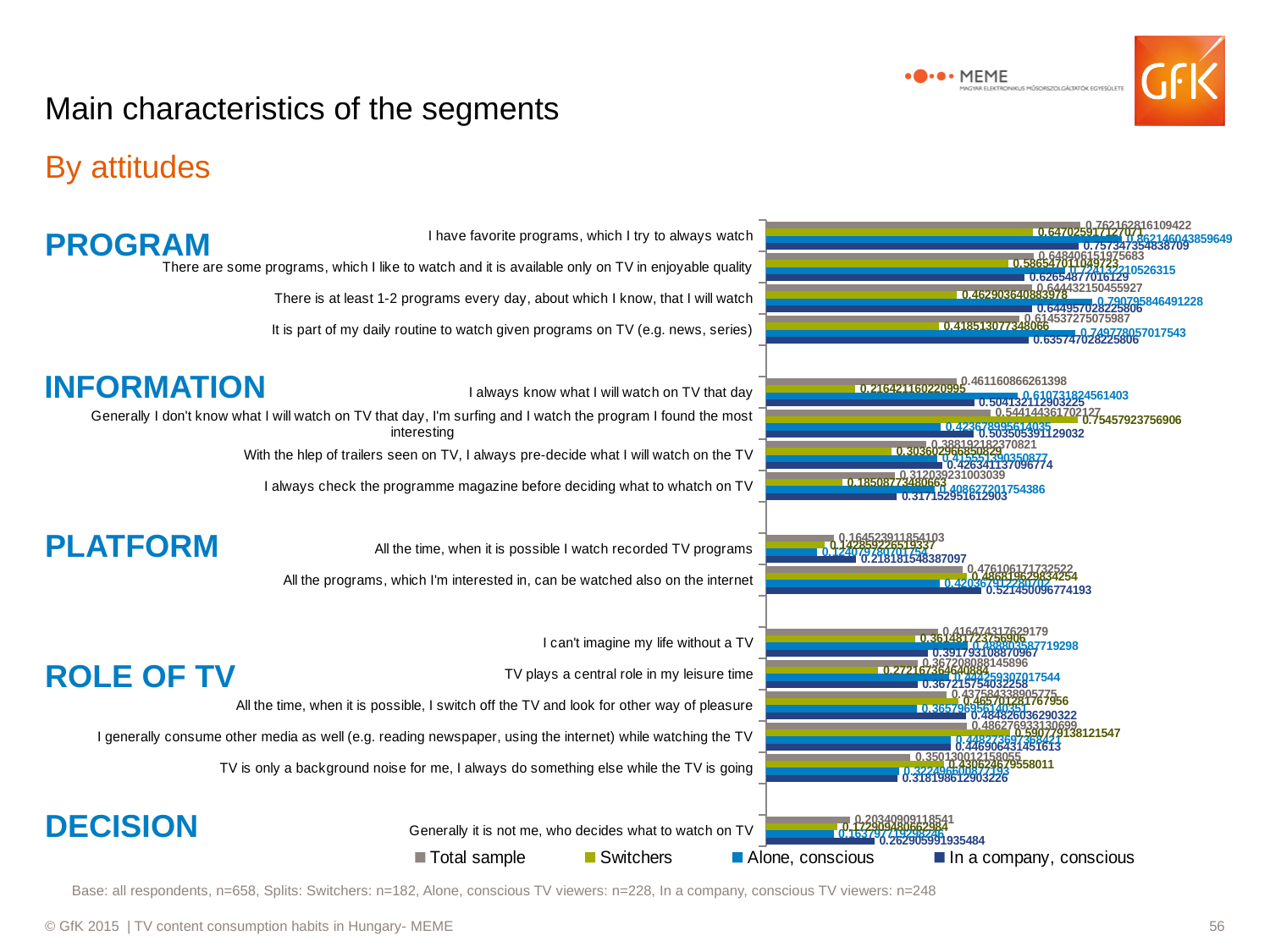
Which series has the lowest value for 'Generally it is not me, who decides what to watch on TV'? Alone, conscious What is the Switchers value for 'I have favorite programs, which I try to always watch'? 0.647025917127071 Which series are listed in the legend? Total sample, Switchers, Alone, conscious, In a company, conscious What is the 'In a company, conscious' value for 'Generally it is not me, who decides what to watch on TV'? 0.262905991935484 For 'Generally I don't know what I will watch on TV that day, I'm surfing and I watch the program I found the most interesting', which is larger: the Switchers value or the Total sample value? Switchers Which series has the highest value for 'I have favorite programs, which I try to always watch'? Alone, conscious How many series does the legend list? 4 How many attitude statements (categories) are plotted in the chart? 16 What kind of chart is shown on the slide? bar chart What is the Total sample value for 'I have favorite programs, which I try to always watch'? 0.762162816109422 Which series has the lowest value for 'I always know what I will watch on TV that day'? Switchers What is the Switchers value for 'I always know what I will watch on TV that day'? 0.216421160220995